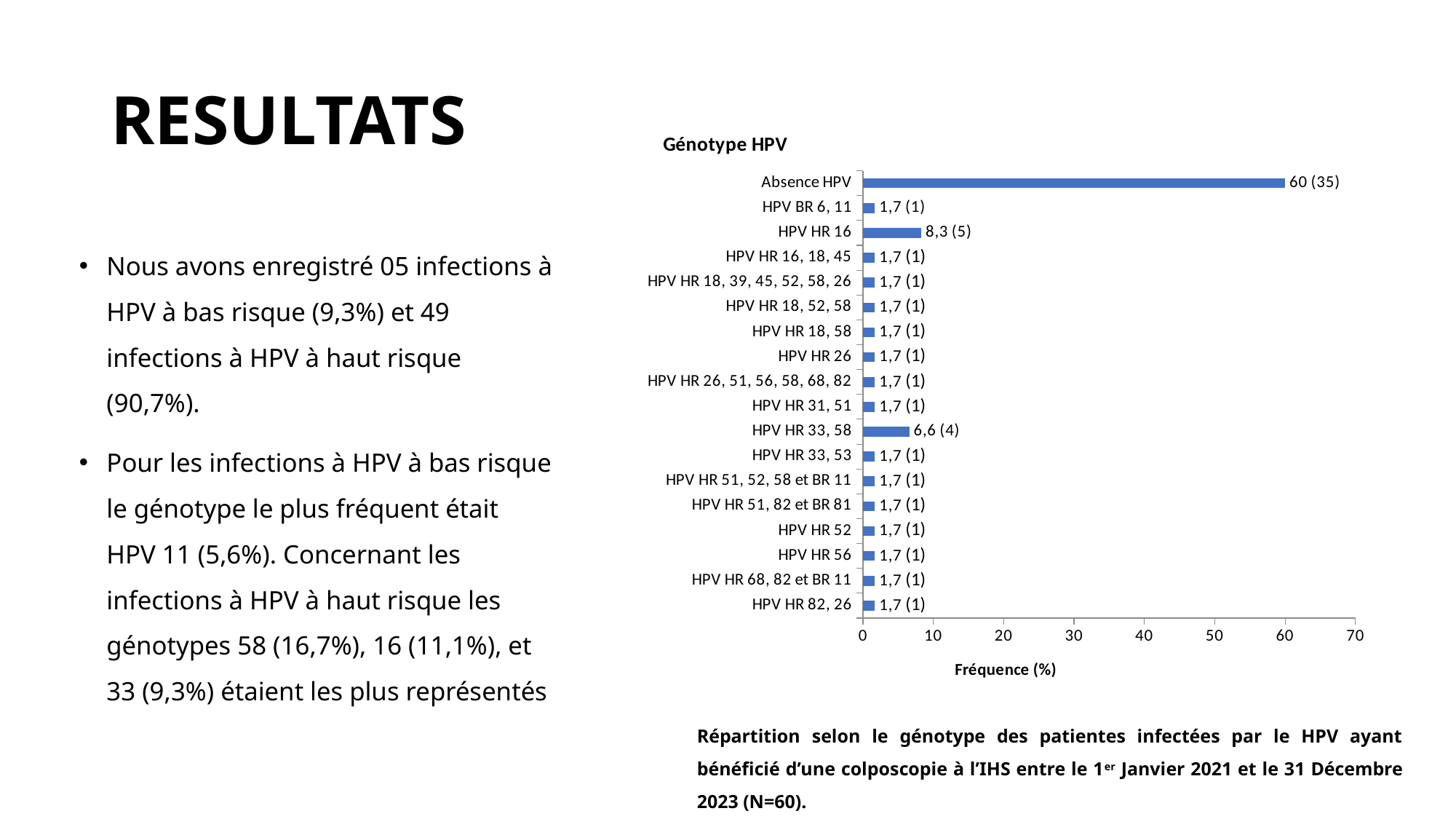
What is the title of the horizontal axis of the chart? Fréquence (%) Which has a higher frequency, HPV HR 16 or HPV HR 33, 58? HPV HR 16 How many categories are shown on the chart? 18 What is the difference in frequency (%) between HPV HR 16 and HPV HR 33, 58? 1,7 What is the data label shown for HPV BR 6, 11? 1,7 (1) What type of chart is shown on the slide? Bar chart What is the data label shown for HPV HR 16? 8,3 (5) Is the frequency for Absence HPV greater or less than 50? greater What is the difference in frequency (%) between Absence HPV and HPV HR 16? 51,7 What is the data label shown for HPV HR 33, 58? 6,6 (4) What is the data label shown for Absence HPV? 60 (35) Which category has the highest frequency? Absence HPV